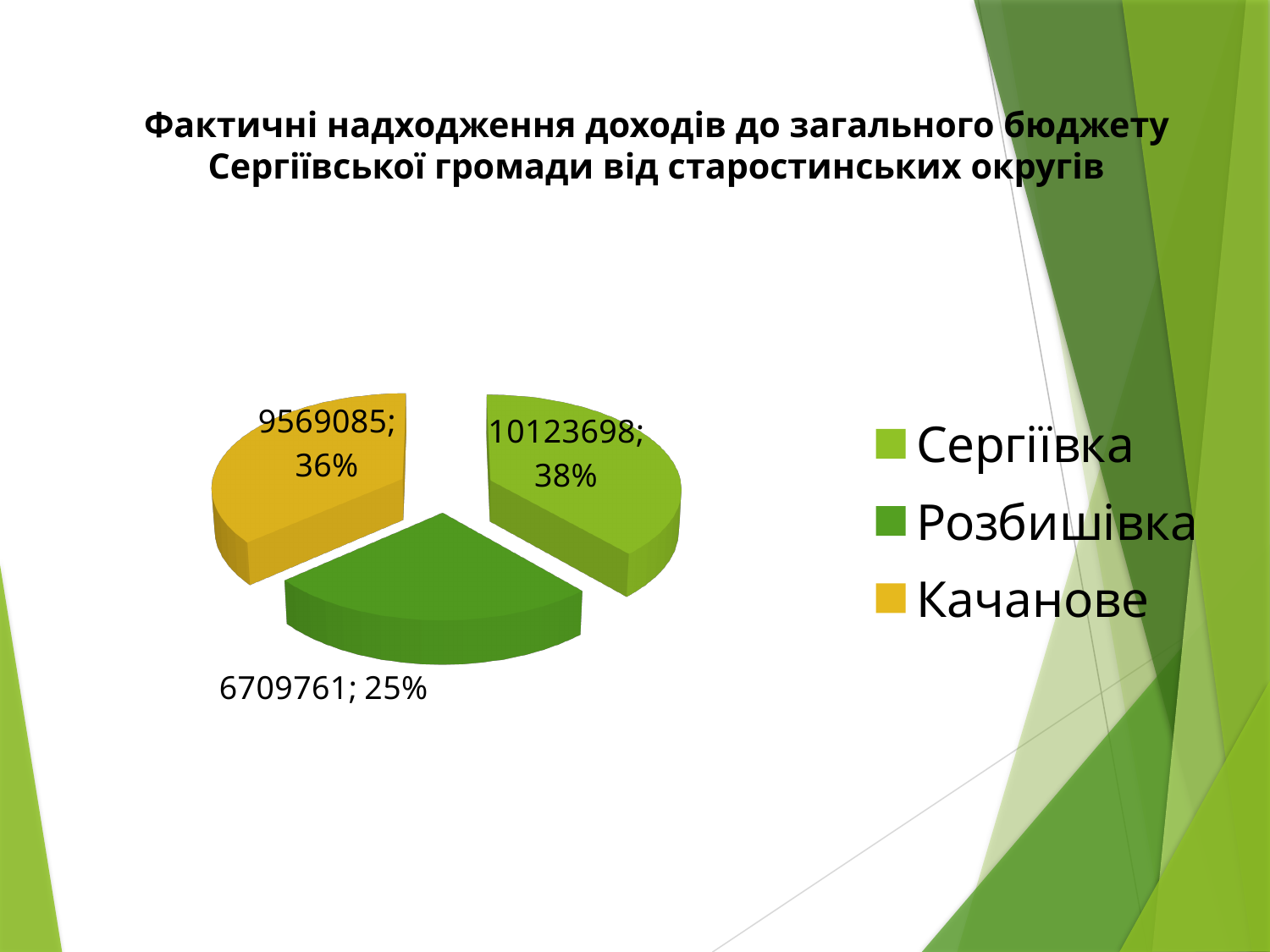
Which district has the largest slice? Сергіївка Which colour represents Качанове in the pie chart? yellow How many slices does the pie chart have? 3 Which district has the smallest slice? Розбишівка What is the value for Розбишівка? 6709761 What is the value for Качанове? 9569085 What share of the pie does Сергіївка represent? 38% What is the value for Сергіївка? 10123698 What is the difference between the values for Сергіївка and Розбишівка? 3413937 What kind of chart is shown on the slide? pie chart How many entries does the legend list? 3 What share of the pie does Качанове represent? 36%